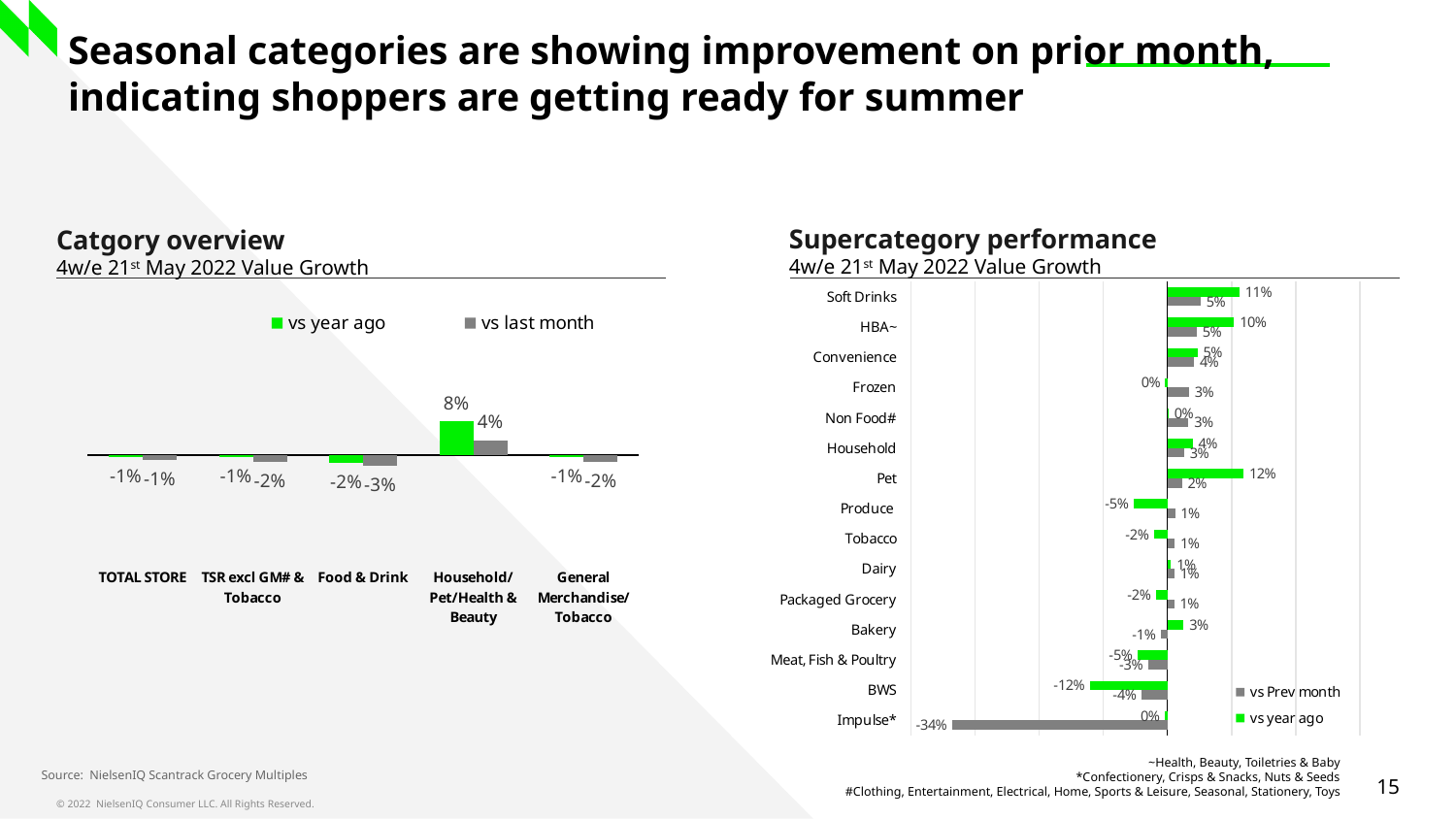
In the Supercategory performance chart, what is the vs Prev month value for Impulse*? -34% What type of chart is the Supercategory performance chart? Bar chart In the Catgory overview chart, what is the difference between the vs year ago and vs last month values for Household/Pet/Health & Beauty? 4 percentage points In the Catgory overview chart, which category has the highest vs year ago value? Household/Pet/Health & Beauty In the Supercategory performance chart, which supercategory has the lowest vs year ago value? BWS In the Catgory overview chart, what is the vs last month value for Food & Drink? -3% In the Catgory overview chart, what is the vs year ago value for Household/Pet/Health & Beauty? 8% In the Supercategory performance chart, what is the vs year ago value for Pet? 12% In the Supercategory performance chart, how many supercategories are listed? 15 In the Supercategory performance chart, which is larger: the vs year ago value for Soft Drinks or for HBA~? Soft Drinks How many series does the legend of the Supercategory performance chart list? 2 In the Catgory overview chart, how many categories are shown on the x axis? 5